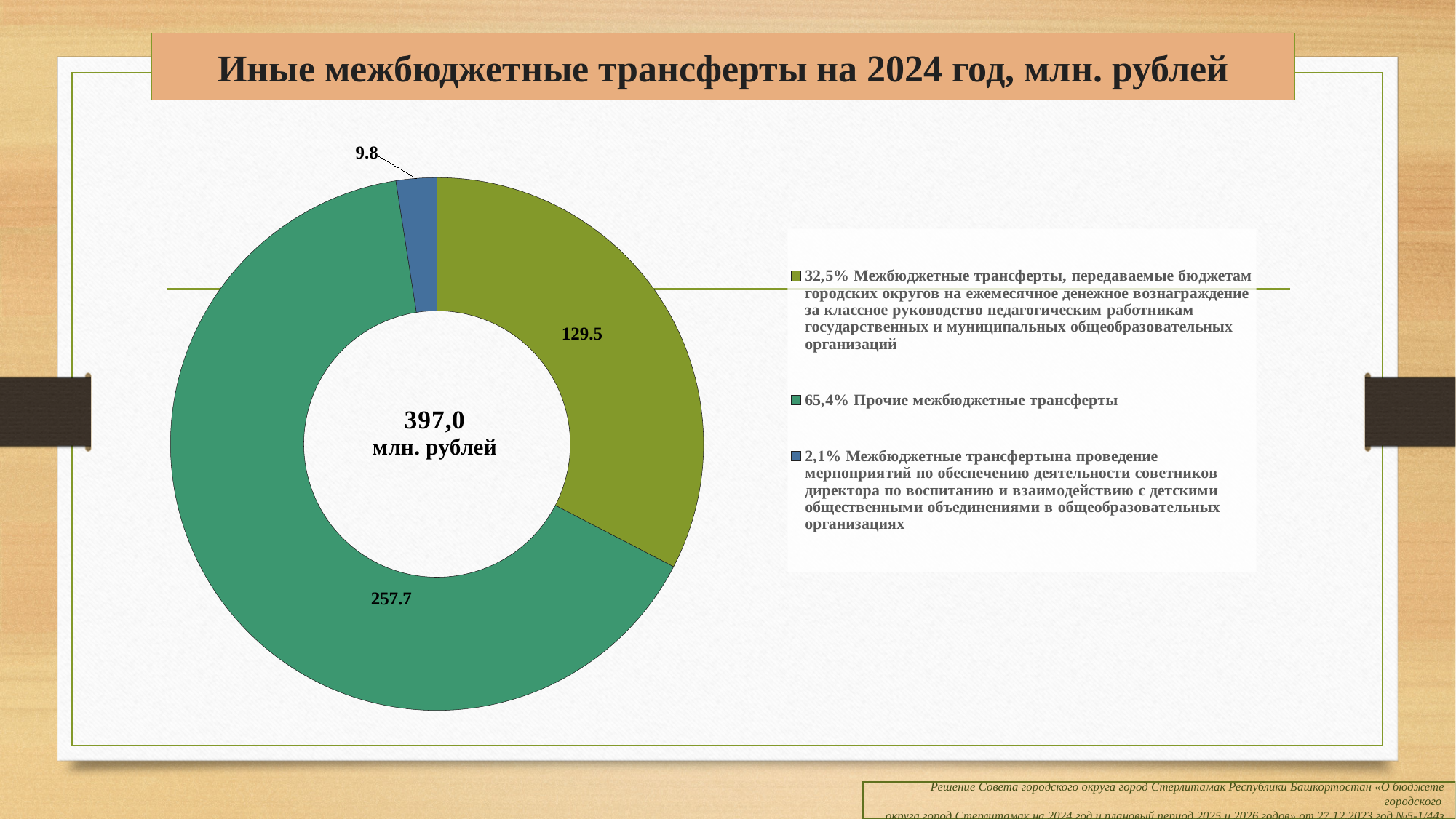
What is the value for «Межбюджетные трансферты на проведение мероприятий по обеспечению деятельности советников директора по воспитанию и взаимодействию с детскими общественными объединениями в общеобразовательных организациях»? 9.8 How many slices does the chart have? 3 What total is shown in the centre of the chart? 397,0 млн. рублей What is the value for «Межбюджетные трансферты, передаваемые бюджетам городских округов на ежемесячное денежное вознаграждение за классное руководство педагогическим работникам государственных и муниципальных общеобразовательных организаций»? 129.5 What share of the total does the slice labelled 9.8 represent? 2,1% What is the value for «Прочие межбюджетные трансферты»? 257.7 Which category has the largest slice? Прочие межбюджетные трансферты What share of the total does «Прочие межбюджетные трансферты» represent? 65,4% What is the difference between the value for «Прочие межбюджетные трансферты» and the value for the slice labelled 129.5? 128.2 Which is larger: the slice for «Прочие межбюджетные трансферты» or the slice for transfers for classroom leadership remuneration (129.5)? Прочие межбюджетные трансферты What kind of chart is shown on the slide? Doughnut (pie) chart